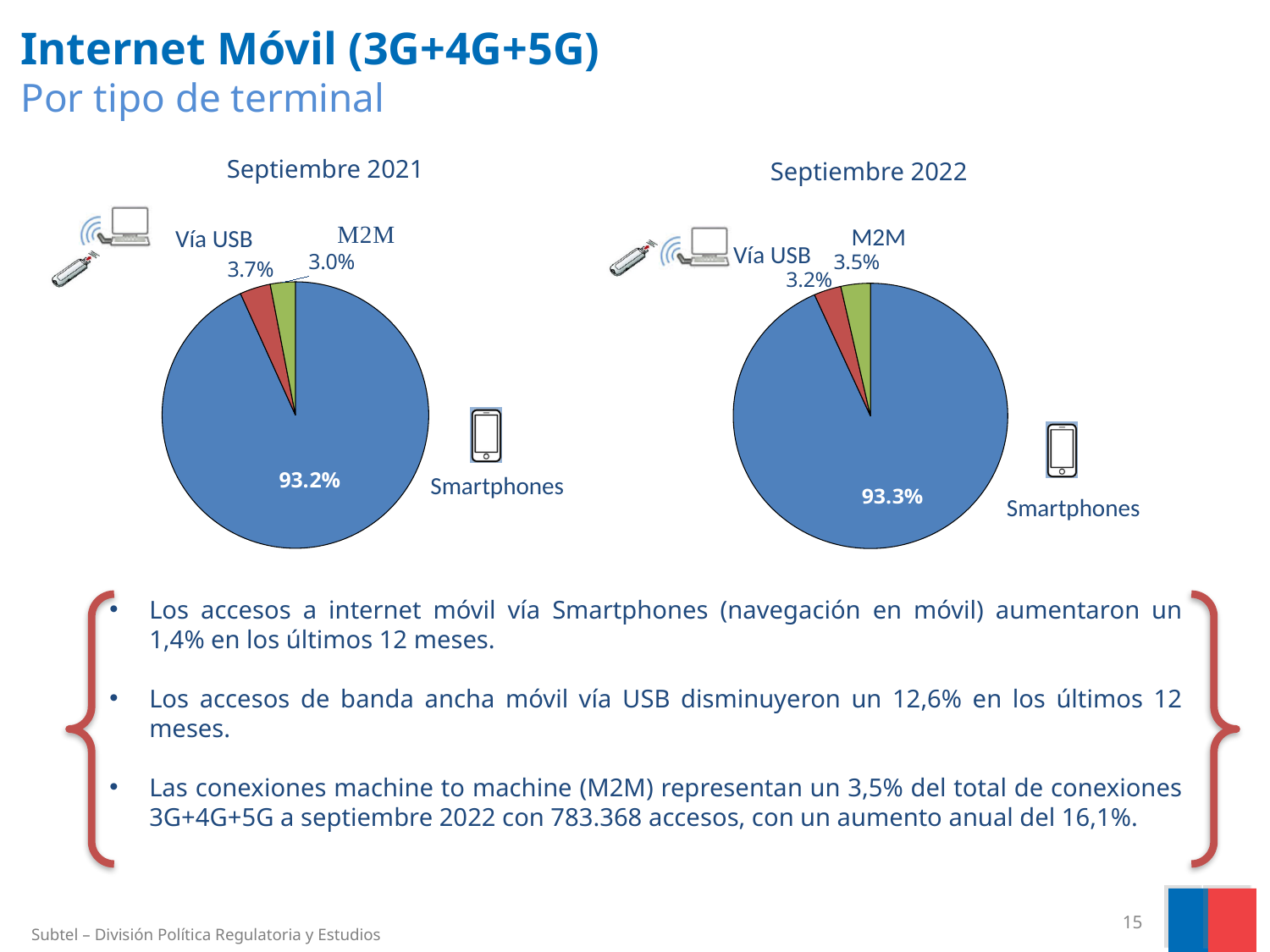
In the Septiembre 2022 chart, what share do Smartphones have? 93.3% In the Septiembre 2022 chart, what is the share for M2M? 3.5% In the Septiembre 2022 chart, which is larger, Vía USB or M2M? M2M In the Septiembre 2021 chart, which category has the smallest share? M2M In the Septiembre 2022 chart, which category has the largest share? Smartphones What type of chart is the Septiembre 2022 chart? Pie chart In the Septiembre 2021 chart, what is the share for Vía USB? 3.7% How many slices does the Septiembre 2021 chart have? 3 In the Septiembre 2021 chart, what share do Smartphones have? 93.2% In the Septiembre 2021 chart, what is the difference between the Vía USB share and the M2M share? 0.7% In the Septiembre 2022 chart, what is the share for Vía USB? 3.2% In the Septiembre 2022 chart, what colour is the Smartphones slice? Blue